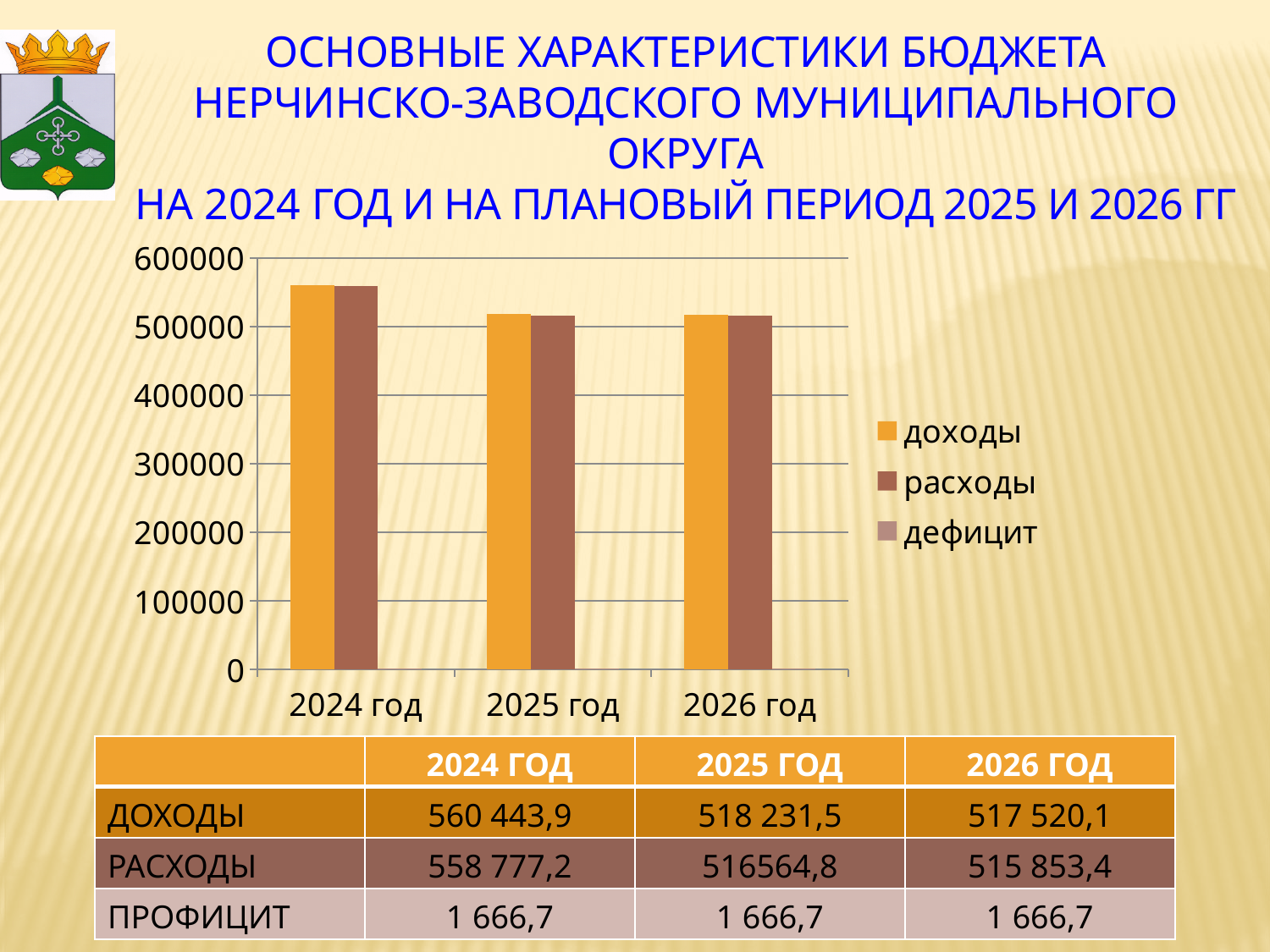
Is the value of расходы for 2026 год greater or less than 600000? less What is the value of доходы for 2024 год according to the slide? 560 443,9 What is the value of расходы for 2026 год according to the slide? 515 853,4 How many year categories are shown on the x axis of the chart? 3 Do the доходы values rise or fall from 2024 год to 2026 год? fall Which series are listed in the chart legend? доходы, расходы, дефицит What kind of chart is shown on the slide? bar chart Is the value of доходы for 2024 год greater or less than 500000? greater In which year are доходы (revenues) highest in the chart? 2024 год How many series does the chart legend list? 3 What is the difference between доходы and расходы for 2024 год according to the slide? 1 666,7 Is the value of расходы for 2025 год greater or less than 400000? greater